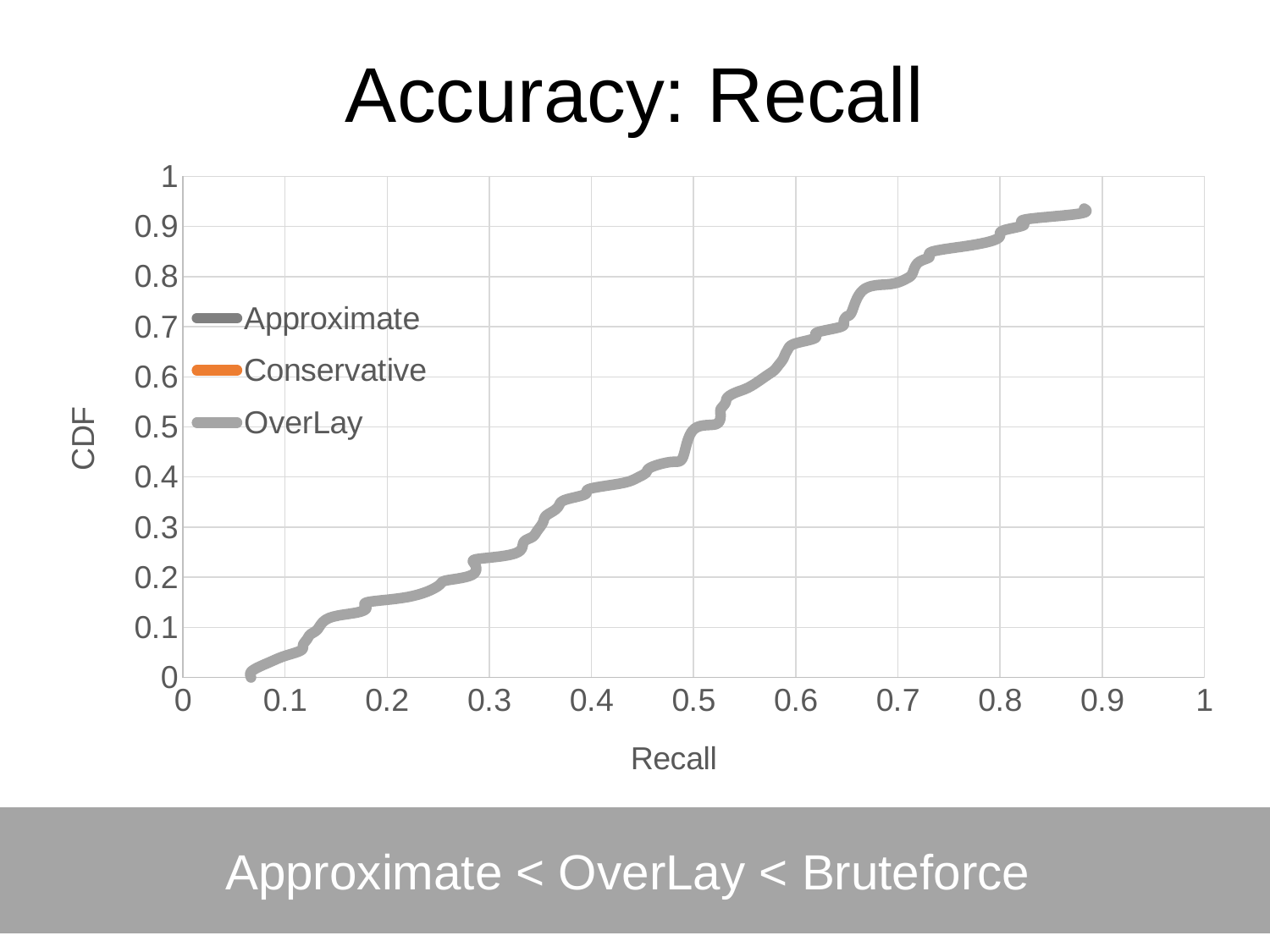
What kind of chart is shown on the slide? line chart Is the CDF value at a Recall of 0.7 greater or less than 0.7? greater What is the title of the chart? Accuracy: Recall Is the highest CDF value reached by the curve greater or less than 0.9? greater Is the Recall value at which the curve starts (CDF of 0) greater or less than 0.1? less Does the CDF curve rise or fall as Recall increases along the x axis? rise What is the label of the y axis? CDF How many series does the legend list? 3